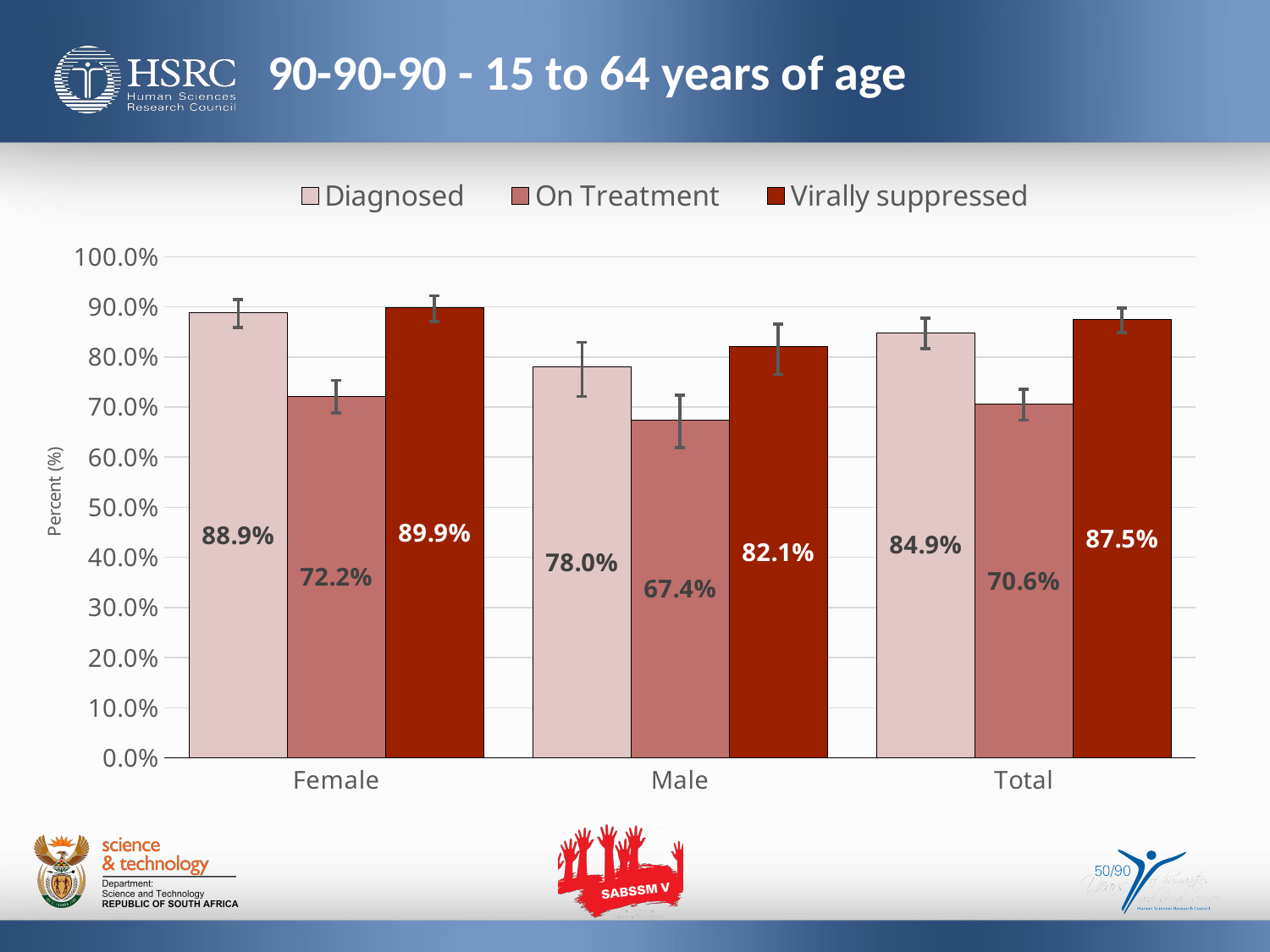
What kind of chart is shown on the slide? Bar chart What is the Virally suppressed value for Total? 87.5% What is the Diagnosed value for Female? 88.9% What is the label of the y axis? Percent (%) Which category has the lowest On Treatment value? Male Which category has the highest Virally suppressed value? Female What is the difference between the Diagnosed values for Female and Male? 10.9% What is the On Treatment value for Male? 67.4% Is the Virally suppressed value for Male greater or less than 80.0%? greater Which is larger: the On Treatment value for Female or for Total? Female How many categories are shown on the x axis? 3 How many series does the legend list? 3